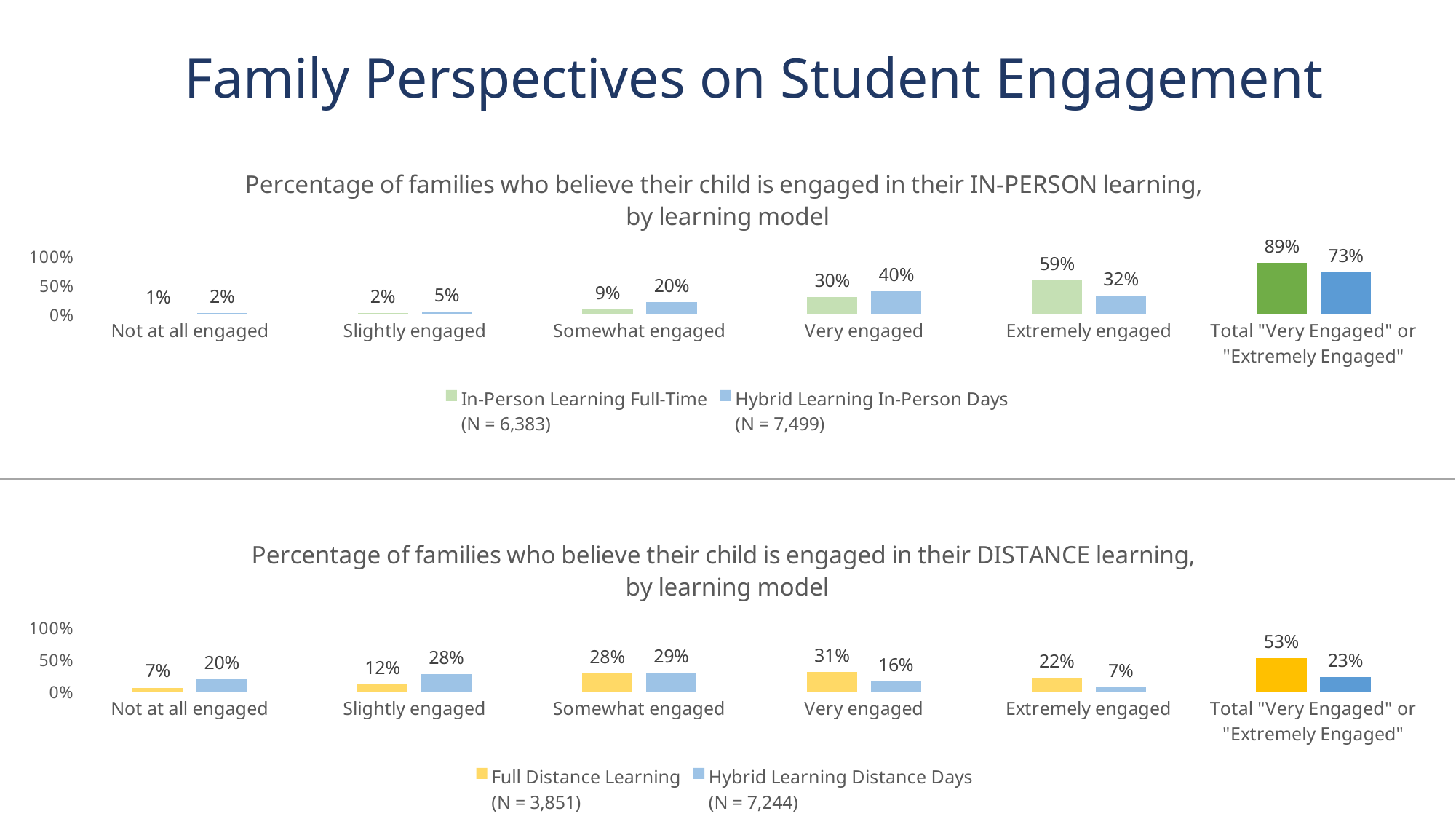
In the IN-PERSON learning chart, which category has the highest value for In-Person Learning Full-Time? Total "Very Engaged" or "Extremely Engaged" In the IN-PERSON learning chart, what percentage of In-Person Learning Full-Time families said their child is Extremely engaged? 59% How many series does the legend of the DISTANCE learning chart list? 2 In the DISTANCE learning chart, which category has the lowest value for Hybrid Learning Distance Days? Extremely engaged In the IN-PERSON learning chart, what is the difference between the In-Person Learning Full-Time and Hybrid Learning In-Person Days values for Total "Very Engaged" or "Extremely Engaged"? 16% In the DISTANCE learning chart, what is the Hybrid Learning Distance Days value for Total "Very Engaged" or "Extremely Engaged"? 23% In the DISTANCE learning chart, is the Full Distance Learning value for Total "Very Engaged" or "Extremely Engaged" greater or less than 50%? greater In the DISTANCE learning chart, what percentage of Full Distance Learning families said their child is Not at all engaged? 7% In the DISTANCE learning chart, which series has the larger value for Very engaged: Full Distance Learning or Hybrid Learning Distance Days? Full Distance Learning What type of chart is the IN-PERSON learning chart? Bar chart How many categories are shown on the x axis of the IN-PERSON learning chart? 6 In the IN-PERSON learning chart, what is the value for Hybrid Learning In-Person Days in the Very engaged category? 40%